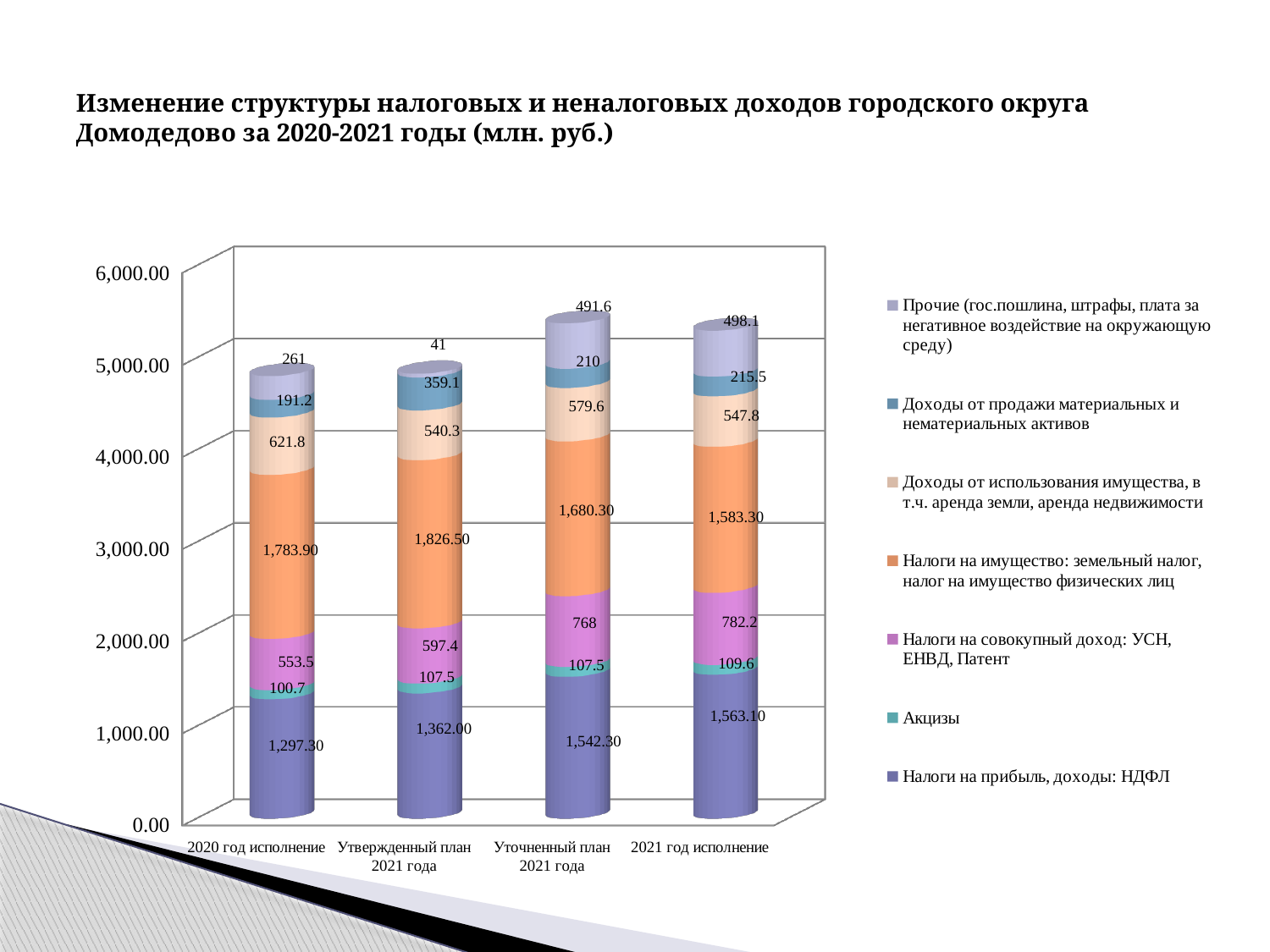
How many categories are shown on the x axis? 4 What kind of chart is shown on the slide? stacked bar chart Which category has the lowest value for Прочие (гос.пошлина, штрафы, плата за негативное воздействие на окружающую среду)? Утвержденный план 2021 года How many series does the legend list? 7 What is the value of Налоги на имущество for Уточненный план 2021 года? 1,680.30 Which category has the highest value for Налоги на прибыль, доходы: НДФЛ? 2021 год исполнение Do the values of Налоги на совокупный доход: УСН, ЕНВД, Патент rise or fall from left to right across the categories? rise What is the value of Прочие (гос.пошлина, штрафы, плата за негативное воздействие на окружающую среду) for Утвержденный план 2021 года? 41 What is the difference between the НДФЛ values for 2021 год исполнение and 2020 год исполнение? 265.80 What is the total of the stacked bar for 2020 год исполнение? 4,809.40 What is the value of Налоги на прибыль, доходы: НДФЛ for 2020 год исполнение? 1,297.30 Which is larger: Налоги на имущество for Утвержденный план 2021 года or for 2021 год исполнение? Утвержденный план 2021 года